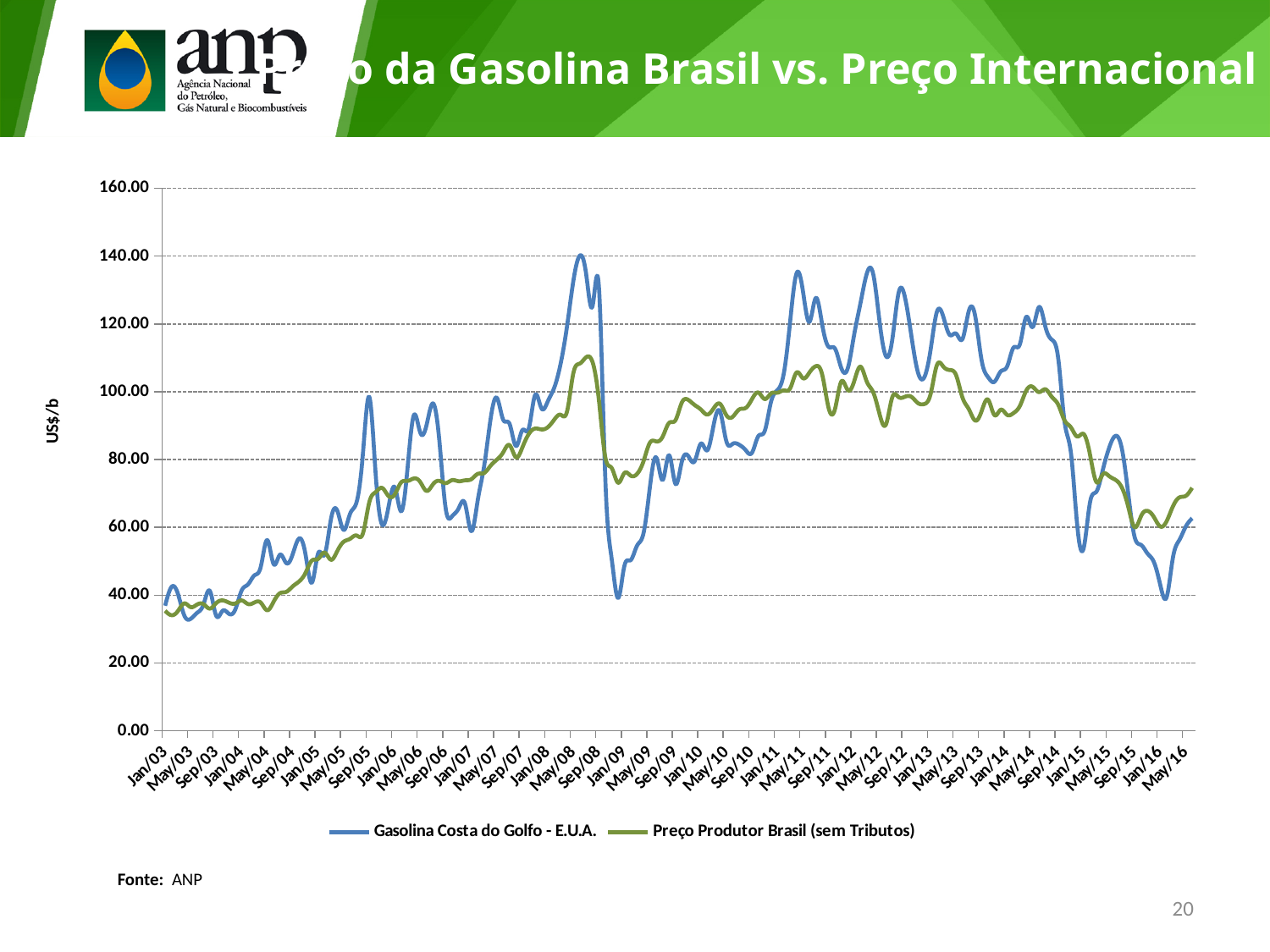
Is the value for Gasolina Costa do Golfo - E.U.A. at Jan/03 greater or less than 60? less What kind of chart is shown on the slide? line chart Which series reaches the highest value anywhere on the chart? Gasolina Costa do Golfo - E.U.A. What unit is shown on the vertical axis? US$/b At May/11, which series has the higher value: Gasolina Costa do Golfo - E.U.A. or Preço Produtor Brasil (sem Tributos)? Gasolina Costa do Golfo - E.U.A. What are the two series named in the legend? Gasolina Costa do Golfo - E.U.A.; Preço Produtor Brasil (sem Tributos) Does the Preço Produtor Brasil (sem Tributos) series generally rise or fall between Jan/03 and Jan/08? rise At Jan/09, which series has the higher value: Gasolina Costa do Golfo - E.U.A. or Preço Produtor Brasil (sem Tributos)? Preço Produtor Brasil (sem Tributos) Is the value for Preço Produtor Brasil (sem Tributos) at May/16 greater or less than 60? greater How many series does the legend list? 2 Is the value for Gasolina Costa do Golfo - E.U.A. at its peak around mid-2008 greater or less than 120? greater